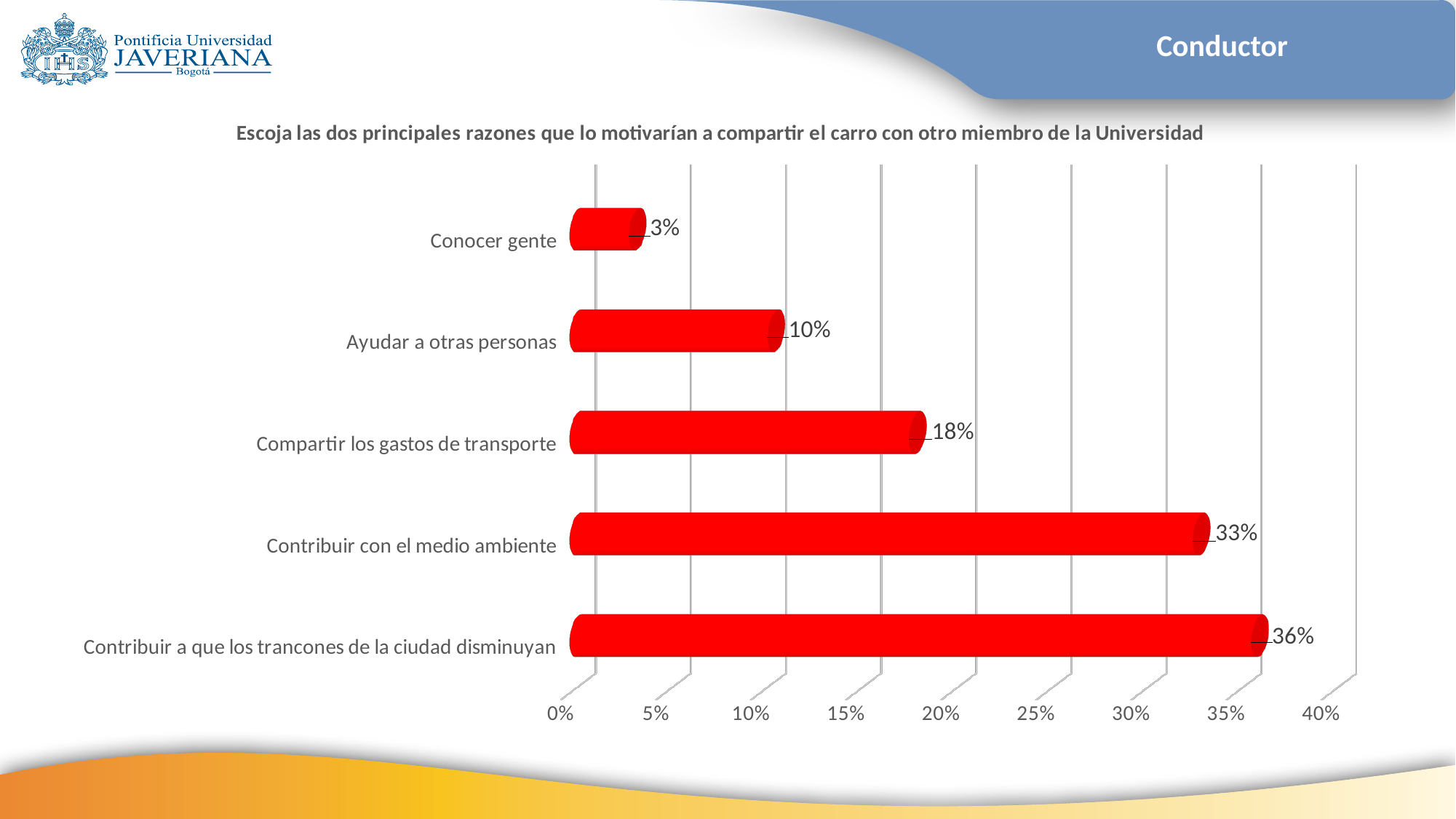
What is the title of the chart? Escoja las dos principales razones que lo motivarían a compartir el carro con otro miembro de la Universidad Which category has the highest value? Contribuir a que los trancones de la ciudad disminuyan Is the value for "Contribuir con el medio ambiente" greater or less than 30%? greater What kind of chart is shown on the slide? bar chart What is the value for "Compartir los gastos de transporte"? 18% What is the difference between the values for "Compartir los gastos de transporte" and "Ayudar a otras personas"? 8% Which category has the lowest value? Conocer gente What is the value for "Conocer gente"? 3% How many categories are shown in the chart? 5 What is the value for "Contribuir con el medio ambiente"? 33% What is the difference between the values for "Contribuir a que los trancones de la ciudad disminuyan" and "Contribuir con el medio ambiente"? 3% Which is larger: the value for "Ayudar a otras personas" or the value for "Compartir los gastos de transporte"? Compartir los gastos de transporte